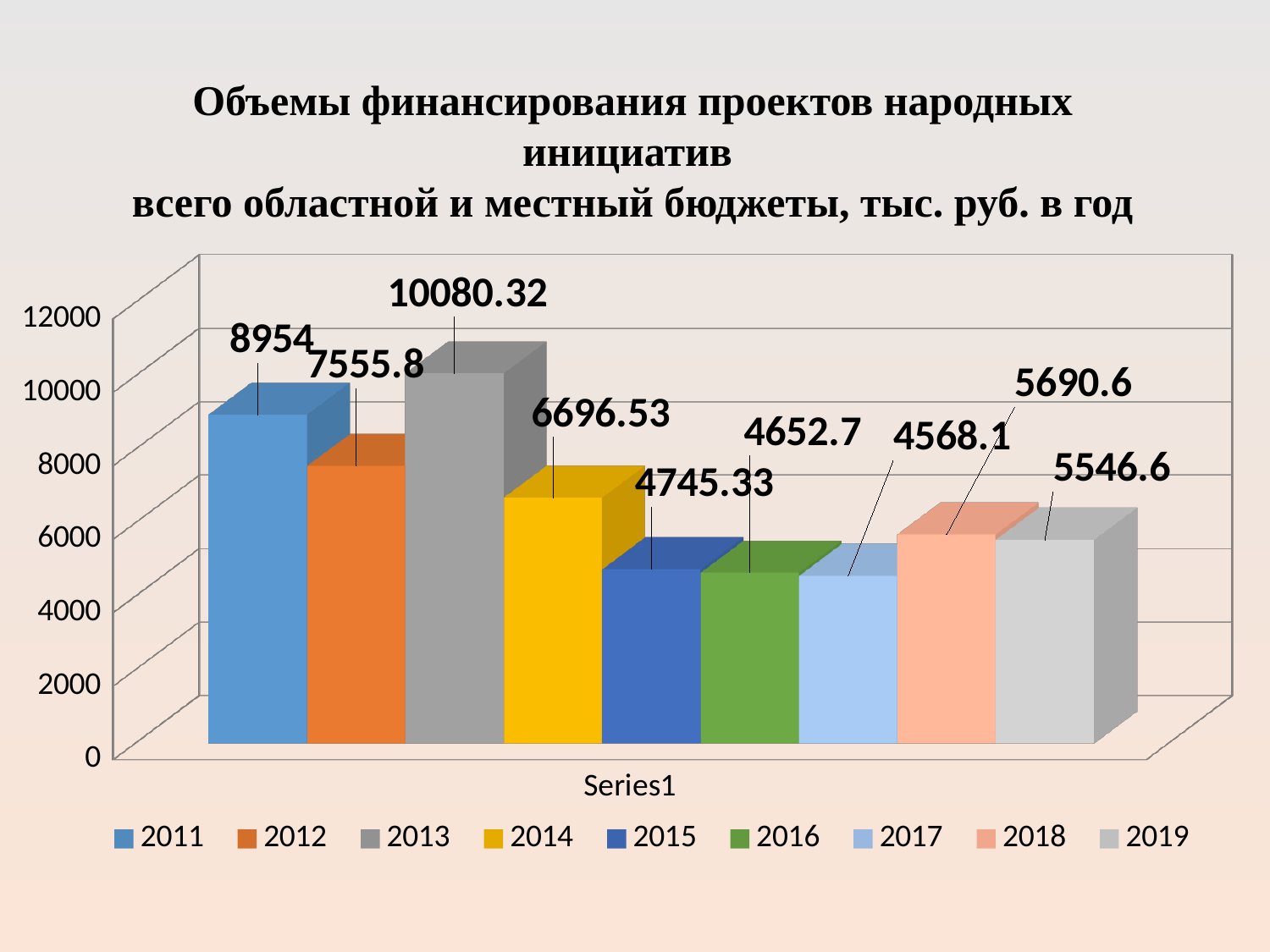
What is the value for 2017? 4568.1 What is the difference between the values for 2013 and 2011? 1126.32 Which is larger, the value for 2012 or the value for 2014? 2012 What is the value for 2011? 8954 What is the value for 2019? 5546.6 What is the difference between the values for 2018 and 2019? 144 Which year has the highest value? 2013 How many series does the legend list? 9 What is the value for 2013? 10080.32 Which year has the lowest value? 2017 Is the value for 2014 greater or less than 6000? greater What kind of chart is shown on the slide? bar chart